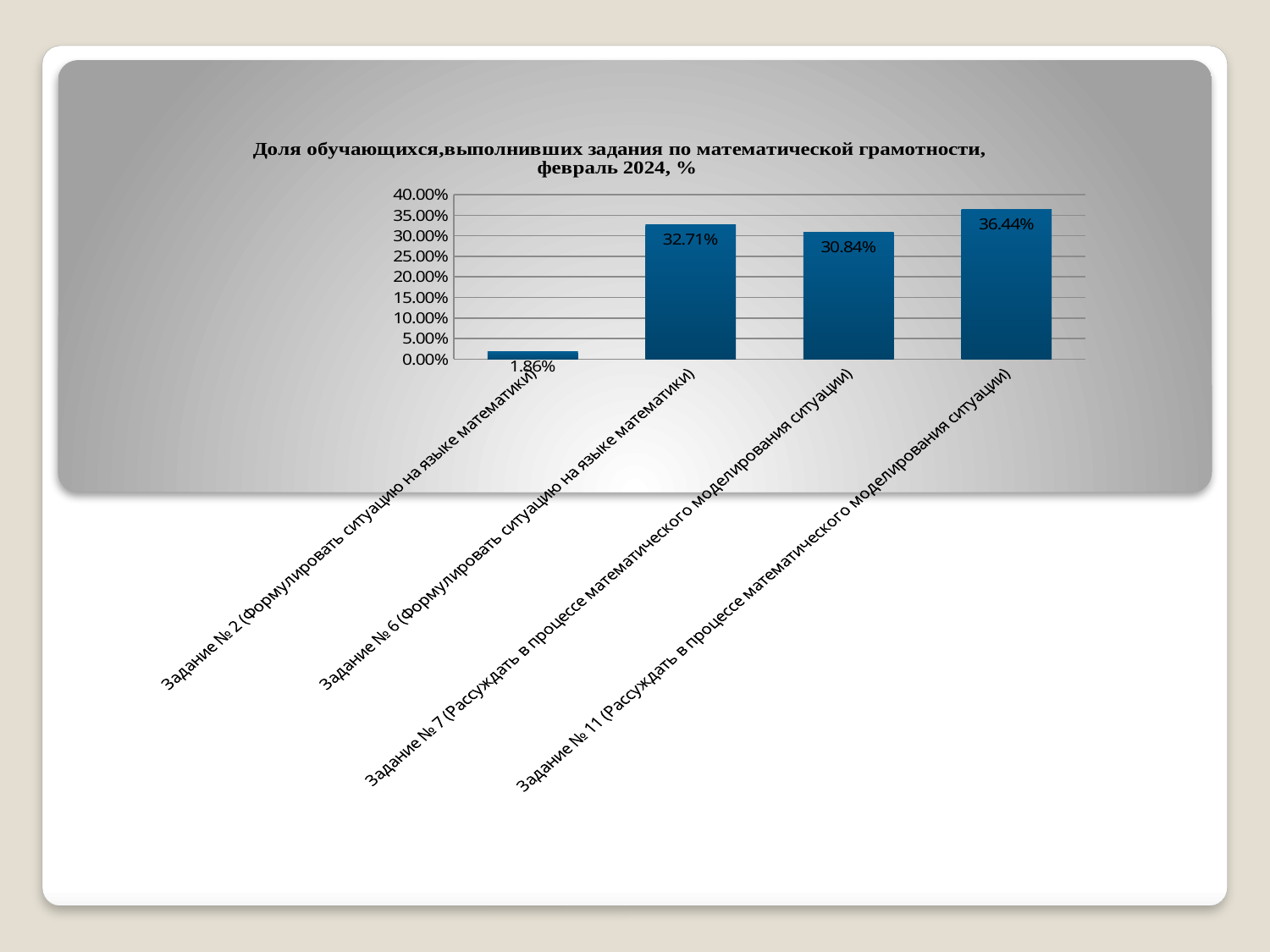
What kind of chart is shown on the slide? Bar chart What is the value for Задание № 7 (Рассуждать в процессе математического моделирования ситуации)? 30.84% Which task has the lowest share of students who completed it? Задание № 2 What is the value for Задание № 11 (Рассуждать в процессе математического моделирования ситуации)? 36.44% Is the value for Задание № 11 greater or less than 35.00%? greater What is the value for Задание № 2 (Формулировать ситуацию на языке математики)? 1.86% Which task has the highest share of students who completed it? Задание № 11 What is the difference between the values for Задание № 6 and Задание № 2? 30.85% What is the value for Задание № 6 (Формулировать ситуацию на языке математики)? 32.71% Which is larger, the value for Задание № 6 or the value for Задание № 7? Задание № 6 What is the difference between the values for Задание № 11 and Задание № 7? 5.60% How many tasks (categories) are shown in the chart? 4